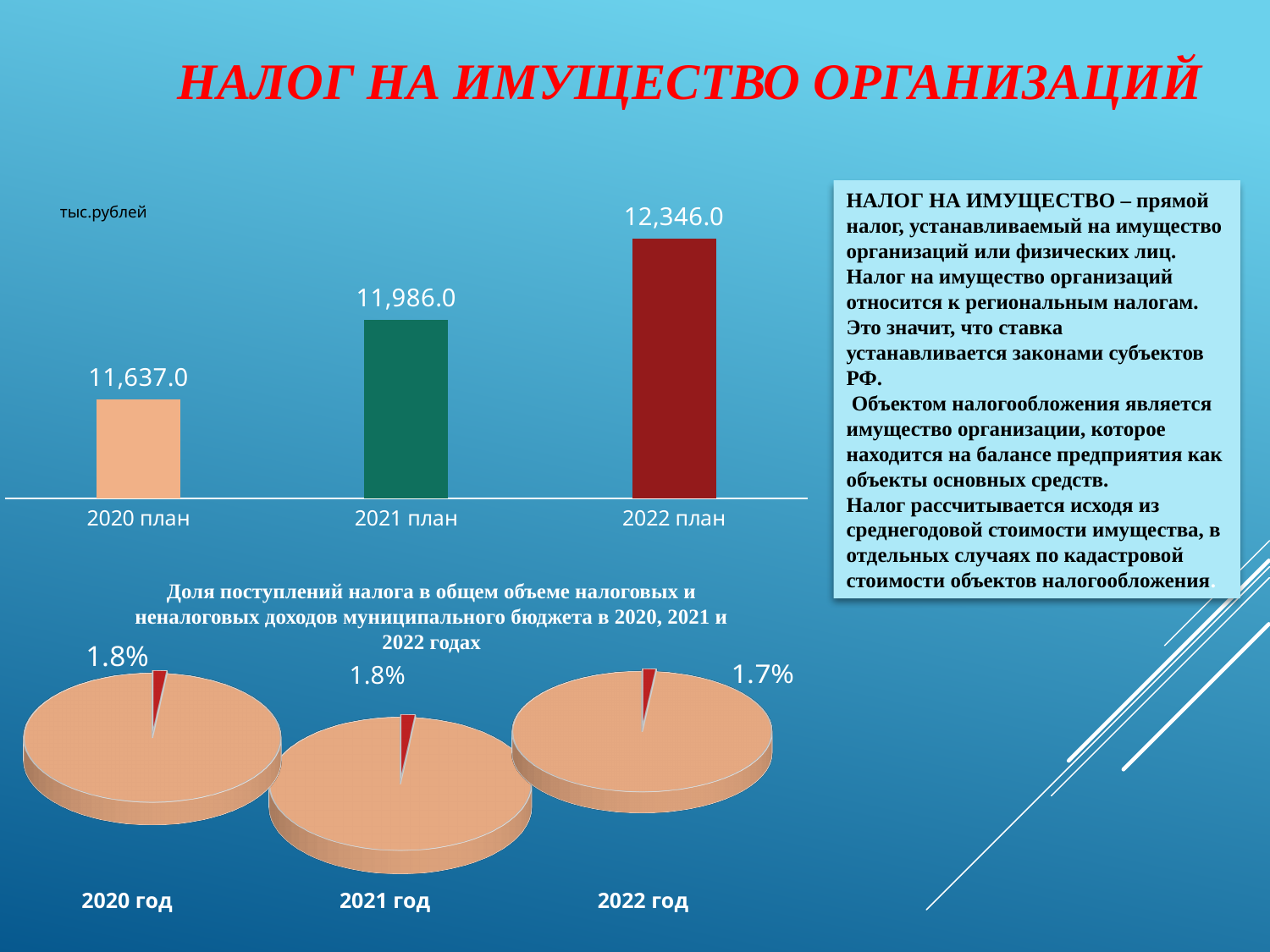
In the bar chart at the top left of the slide, how many bars are plotted? 3 In the bar chart at the top left of the slide, what unit is indicated for the values? тыс.рублей In the bar chart at the top left of the slide, do the values rise or fall from 2020 план to 2022 план? rise In the bar chart at the top left of the slide, what is the difference between the values for 2021 план and 2020 план? 349.0 In the bar chart at the top left of the slide, what is the difference between the values for 2022 план and 2020 план? 709.0 What type of chart is shown at the top left of the slide? bar chart In the bar chart at the top left of the slide, which category has the lowest value? 2020 план In the bar chart at the top left of the slide, what is the value for 2020 план? 11,637.0 In the bar chart at the top left of the slide, which category has the highest value? 2022 план In the bar chart at the top left of the slide, what is the value for 2022 план? 12,346.0 In the pie charts at the bottom of the slide, what share is shown for 2022 год? 1.7% In the bar chart at the top left of the slide, what is the value for 2021 план? 11,986.0